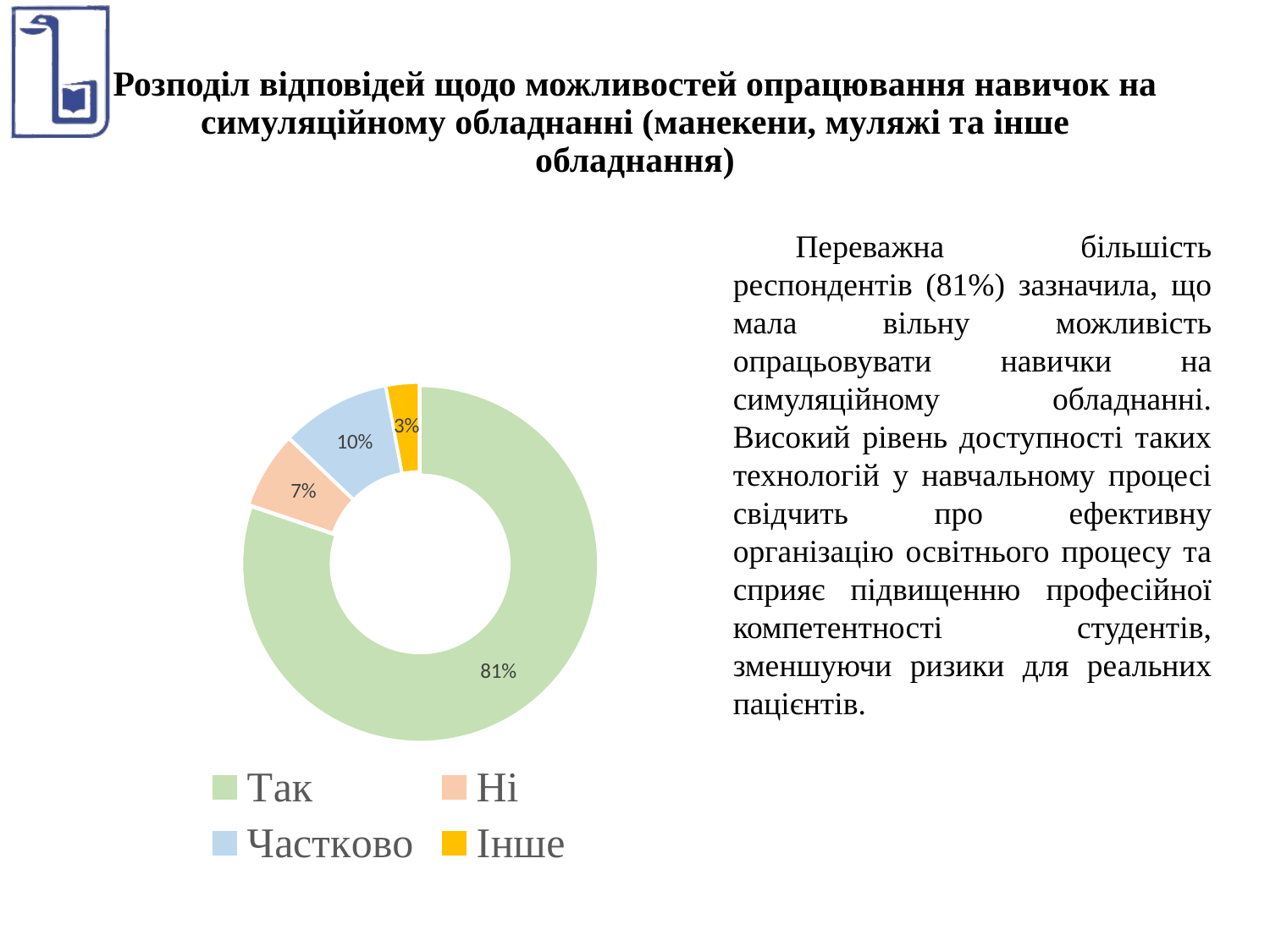
What is the difference in percentage points between the "Так" and "Частково" shares? 71 What is the combined share of "Ні" and "Інше"? 10% What share of responses is labelled "Частково" in the doughnut chart? 10% What kind of chart is shown on the slide? Doughnut (pie) chart What share of responses is labelled "Так" in the doughnut chart? 81% Which category has the smallest share in the chart? Інше Which category has the largest share in the chart? Так What share of responses is labelled "Ні" in the doughnut chart? 7% How many categories does the chart show? 4 What colour represents the "Інше" category in the chart? Yellow What share of responses is labelled "Інше" in the doughnut chart? 3% Which share is larger, "Ні" or "Частково"? Частково